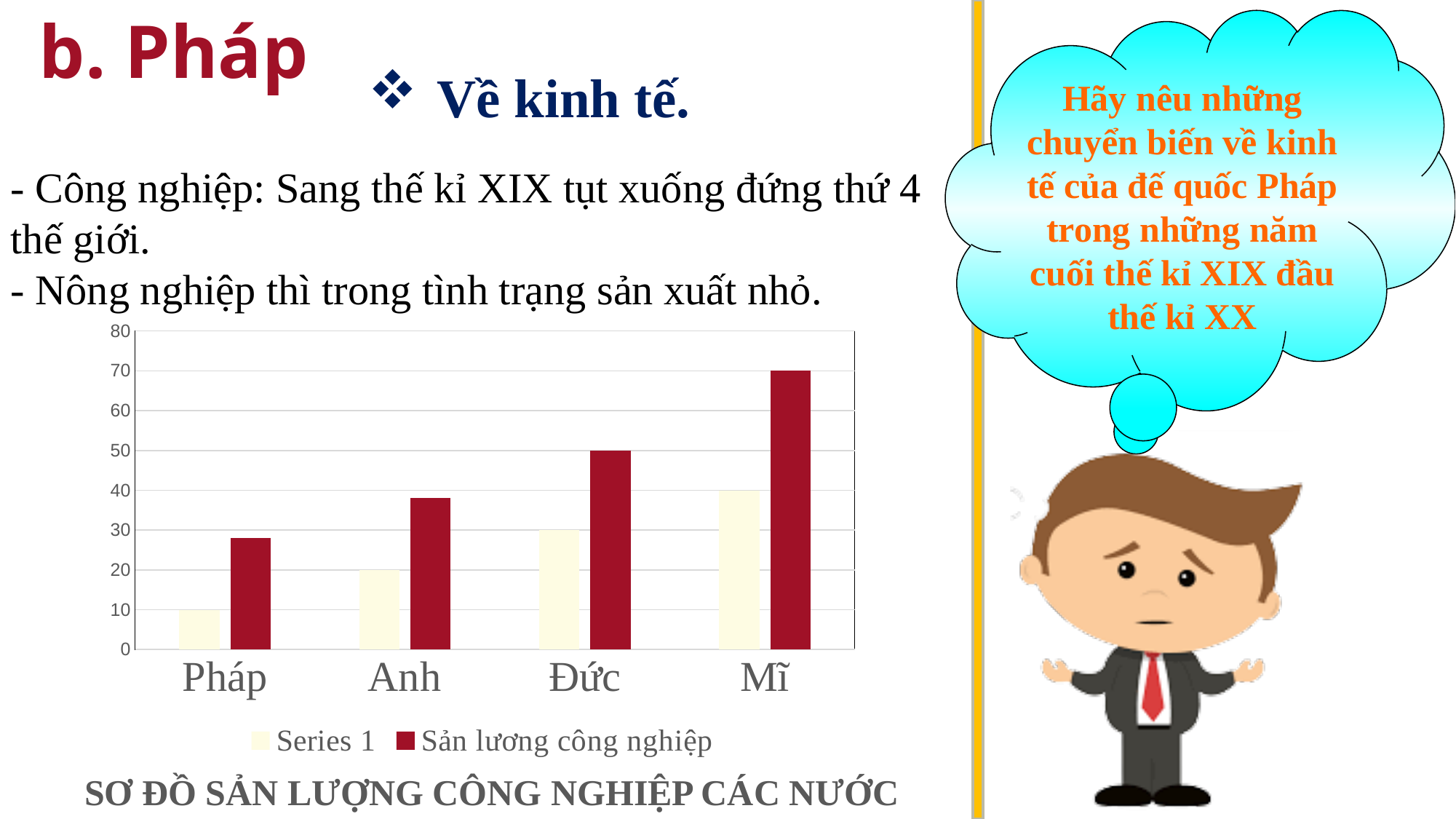
How many series does the chart's legend list? 2 Is the Sản lượng công nghiệp value for Pháp greater or less than 30? less How many countries are shown on the x axis of the chart? 4 Is the Sản lượng công nghiệp value for Anh greater or less than 30? greater What is the difference between the Sản lượng công nghiệp values for Mĩ and Đức? 20 Which country has the lowest value for Sản lượng công nghiệp? Pháp What is the title written below the chart? SƠ ĐỒ SẢN LƯỢNG CÔNG NGHIỆP CÁC NƯỚC What is the Sản lượng công nghiệp value for Đức? 50 Which country has the highest value for Sản lượng công nghiệp? Mĩ What kind of chart is shown on the slide? bar chart Do the Sản lượng công nghiệp values rise or fall from Pháp to Mĩ along the x axis? rise What is the Sản lượng công nghiệp value for Mĩ? 70